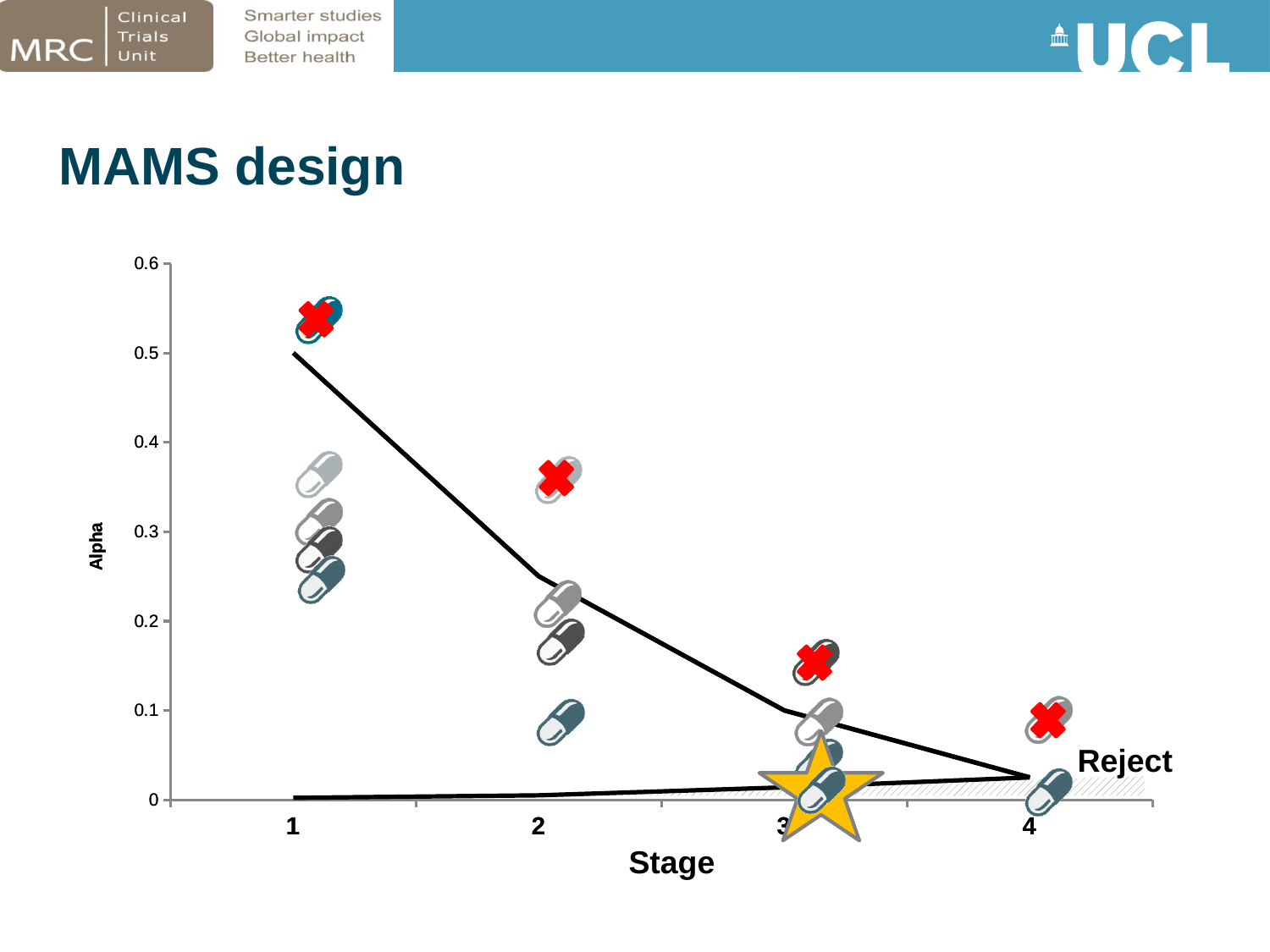
Is the value of the upper black line at stage 4 greater or less than 0.1? less How many stages are shown on the x axis? 4 Is the value of the upper black line at stage 2 greater or less than 0.3? less Is the value of the upper black line at stage 1 greater or less than 0.4? greater At which stage is the upper black line at its lowest value? Stage 4 What is the label of the x axis? Stage What kind of chart is shown on the slide? line chart At which stage is the upper black line at its highest value? Stage 1 Which is larger on the upper black line: the value at stage 1 or the value at stage 3? stage 1 Does the upper black line rise or fall as the stage increases from 1 to 4? fall What is the label of the y axis? Alpha